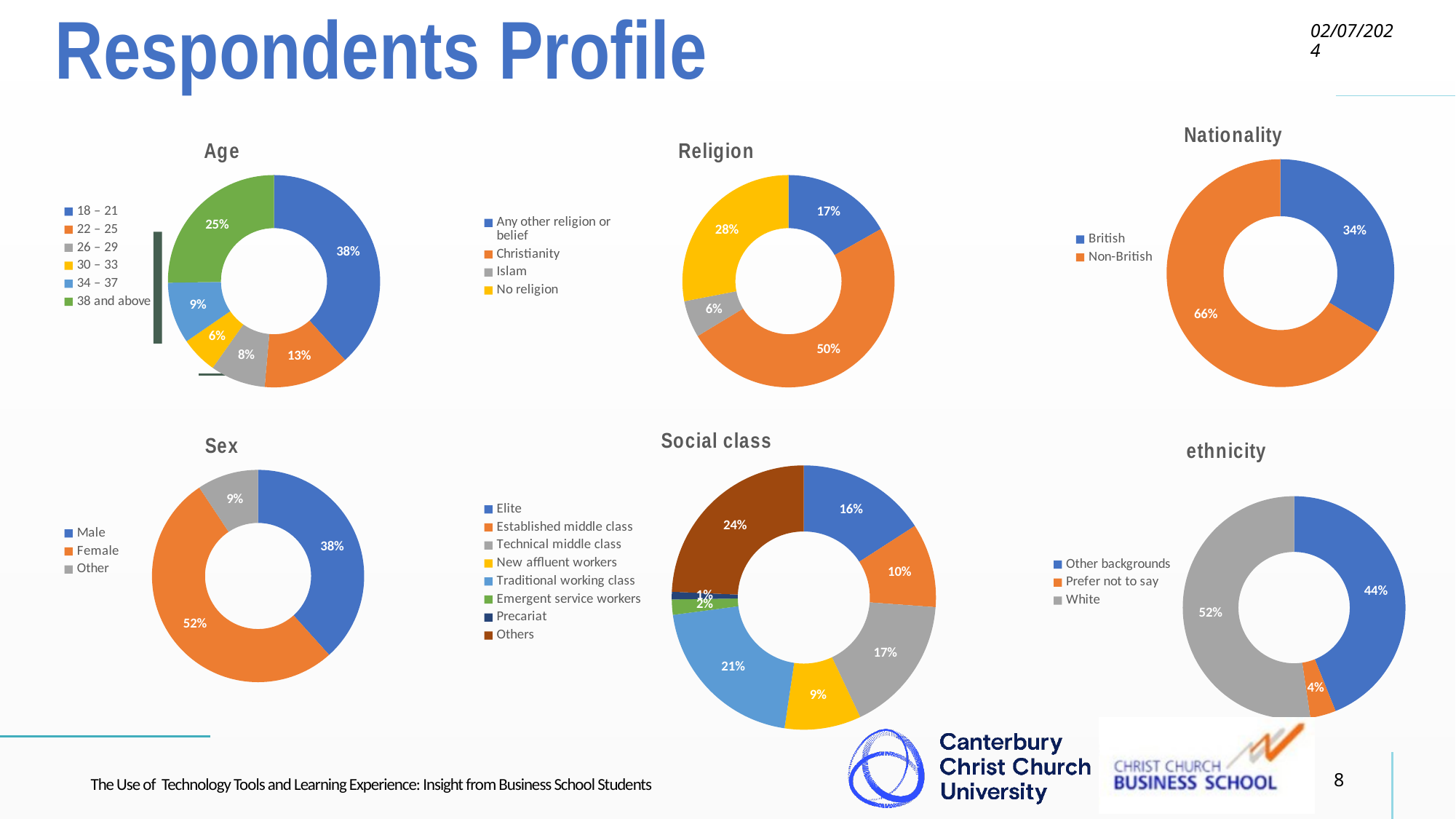
In the Sex chart, what is the difference between the Female and Male shares? 14% In the Sex chart, which category has the largest share? Female In the Social class chart, how many categories does the legend list? 8 In the Religion chart, what is the difference between the No religion share and the Islam share? 22% In the ethnicity chart, which is larger: White or Other backgrounds? White In the Religion chart, what percentage of respondents are Christianity? 50% In the Nationality chart, what share of respondents are Non-British? 66% What kind of chart is used for the Age data? Doughnut (pie) chart In the Age chart, which age group has the smallest share? 30 – 33 In the Social class chart, what share of respondents are Traditional working class? 21% In the Nationality chart, how many categories does the legend list? 2 In the Age chart, what share of respondents are aged 18 – 21? 38%